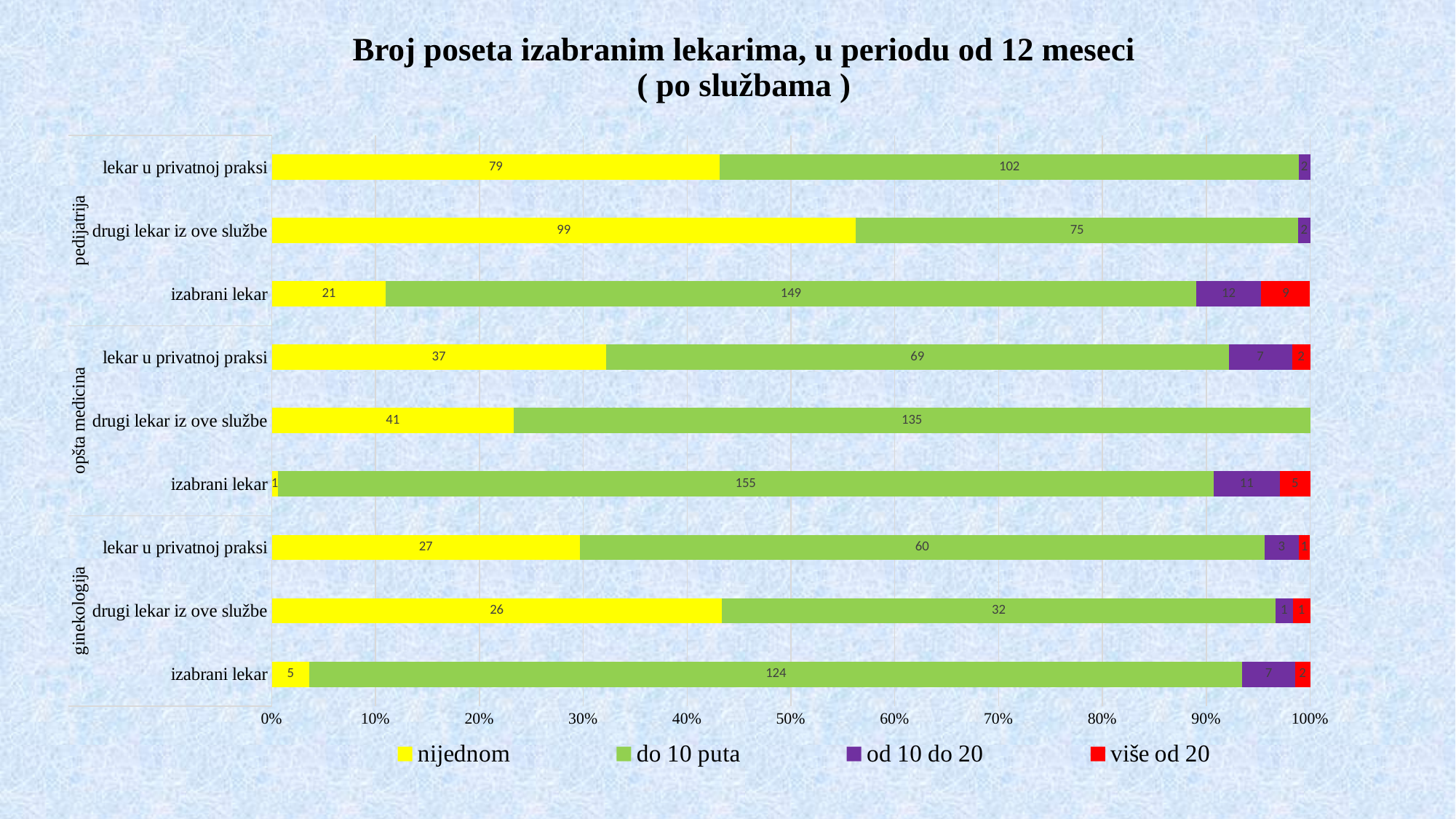
What is the value of 'do 10 puta' for 'izabrani lekar' in the pedijatrija group? 149 What is the value of 'od 10 do 20' for 'izabrani lekar' in the opšta medicina group? 11 What is the difference between the 'do 10 puta' value for 'izabrani lekar' in opšta medicina (155) and in ginekologija (124)? 31 What is the value of 'više od 20' for 'izabrani lekar' in the pedijatrija group? 9 What is the total of the bar for 'izabrani lekar' in the pedijatrija group? 191 Is the 'nijednom' share of the bar for 'drugi lekar iz ove službe' in pedijatrija greater or less than 50%? greater What is the value of 'nijednom' for 'drugi lekar iz ove službe' in the pedijatrija group? 99 What is the value of 'do 10 puta' for 'drugi lekar iz ove službe' in the ginekologija group? 32 Which is larger: the 'nijednom' value for 'lekar u privatnoj praksi' in pedijatrija or in opšta medicina? pedijatrija (79) What kind of chart is shown on the slide? Stacked bar chart How many bars are plotted in the chart? 9 How many series does the legend list? 4